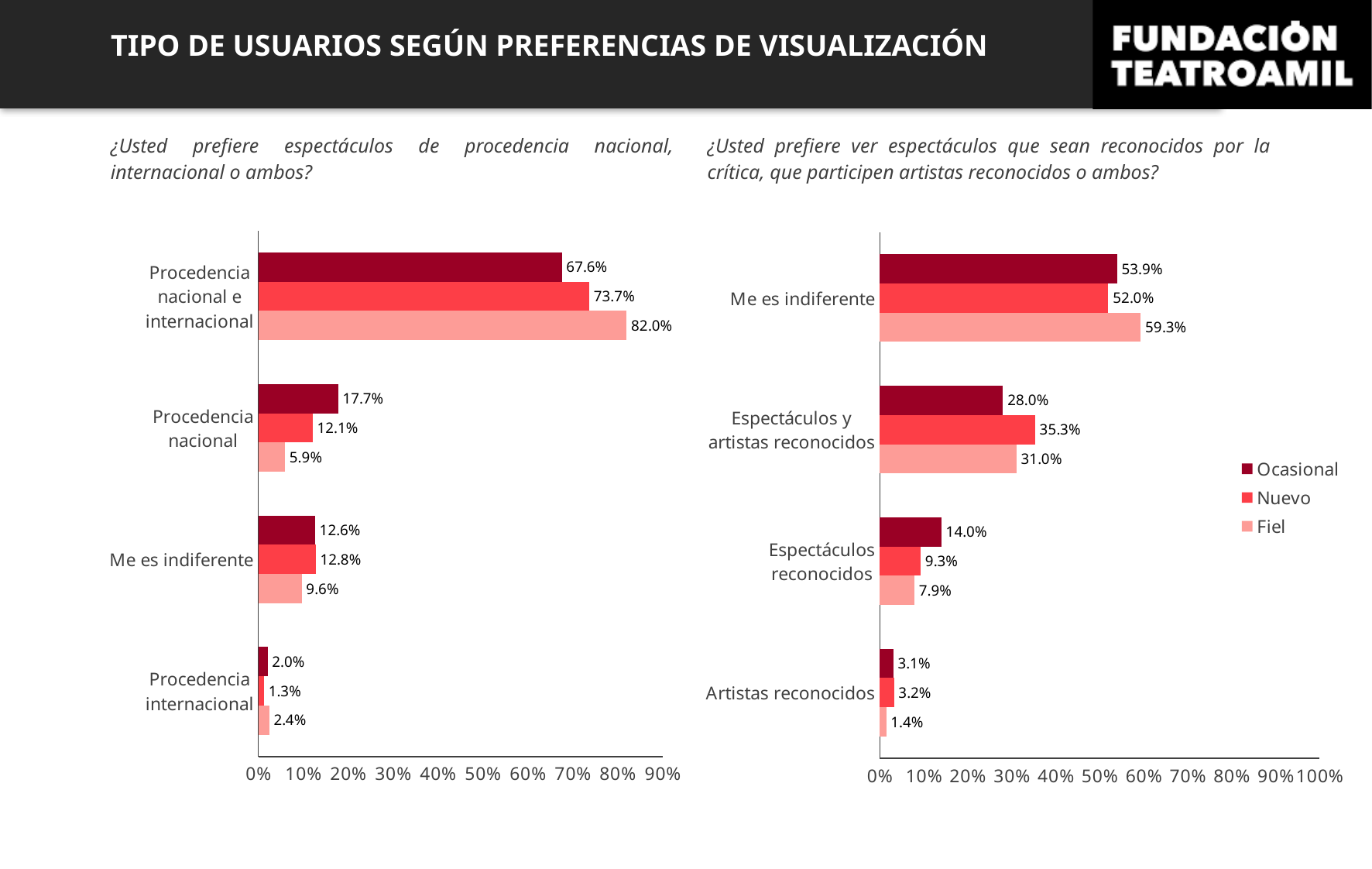
In the right chart, what is the value for Fiel in the 'Me es indiferente' category? 59.3% How many categories are shown in the left chart? 4 In the left chart, what is the value for Ocasional in the 'Procedencia nacional' category? 17.7% In the left chart, which category has the highest value for the Nuevo series? Procedencia nacional e internacional In the right chart, which is larger for 'Espectáculos reconocidos': the Ocasional value or the Fiel value? Ocasional What type of chart is the right chart? Bar chart In the right chart, which category has the lowest value for the Fiel series? Artistas reconocidos In the right chart, is the Ocasional value for 'Me es indiferente' greater or less than 50%? greater In the right chart, what is the value for Nuevo in the 'Espectáculos y artistas reconocidos' category? 35.3% In the left chart, what is the value for Fiel in the 'Procedencia nacional e internacional' category? 82.0% In the left chart, what is the difference between the Fiel and Ocasional values for 'Procedencia nacional e internacional'? 14.4% How many series does the legend list? 3